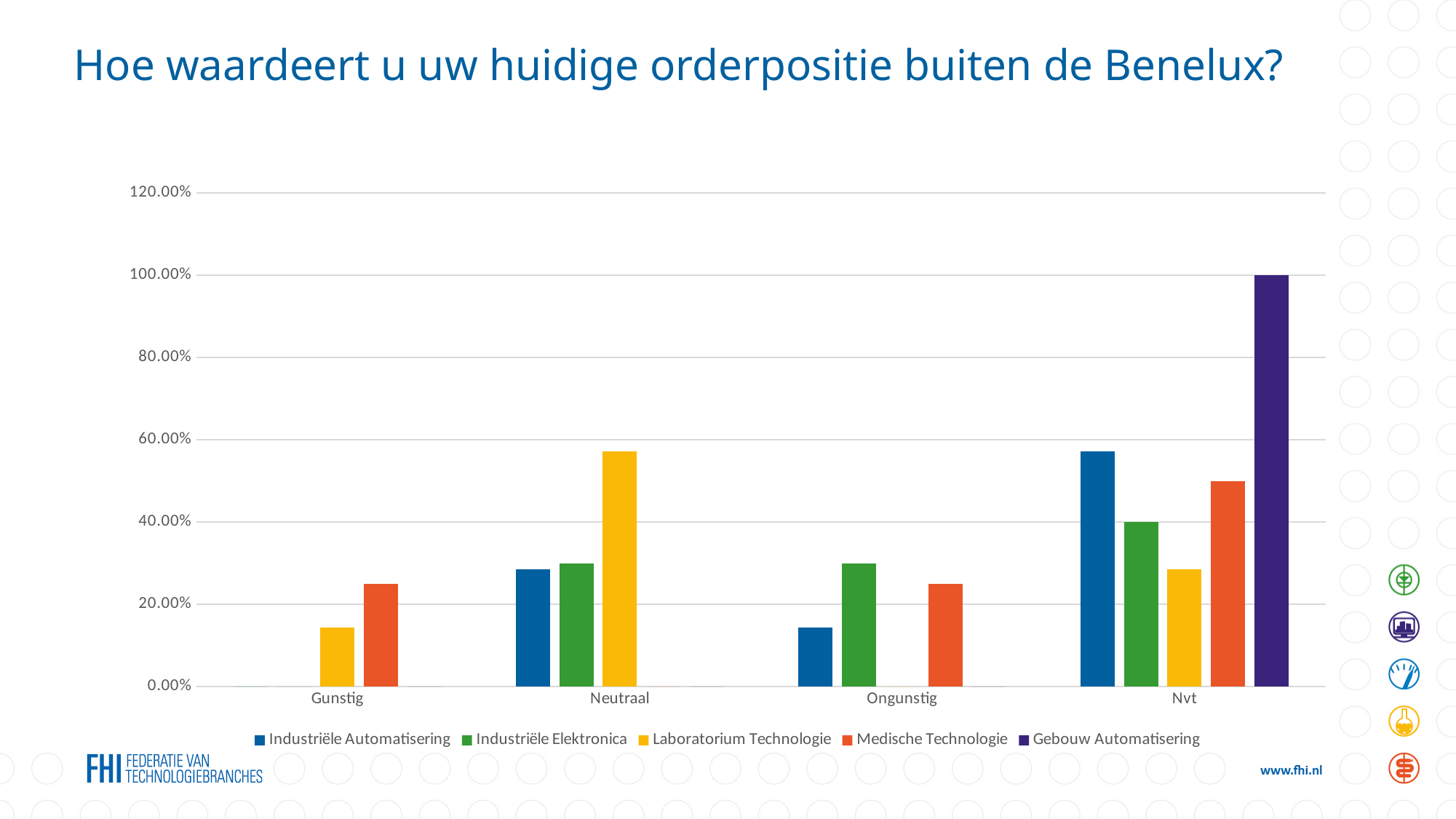
Which series has the highest bar in the Ongunstig category? Industriële Elektronica Which series has the highest bar in the Neutraal category? Laboratorium Technologie Is the value for Laboratorium Technologie in the Neutraal category greater or less than 40.00%? greater What is the value for Industriële Elektronica in the Nvt category? 40.00% Is the value for Industriële Automatisering in the Ongunstig category greater or less than 20.00%? less What type of chart is shown on the slide? bar chart How many series does the legend list? 5 Which series has the lowest bar in the Nvt category? Laboratorium Technologie How many categories are shown on the x axis? 4 What is the value for Gebouw Automatisering in the Nvt category? 100.00% In the Nvt category, which is larger: Industriële Automatisering or Medische Technologie? Industriële Automatisering What is the title of the slide? Hoe waardeert u uw huidige orderpositie buiten de Benelux?